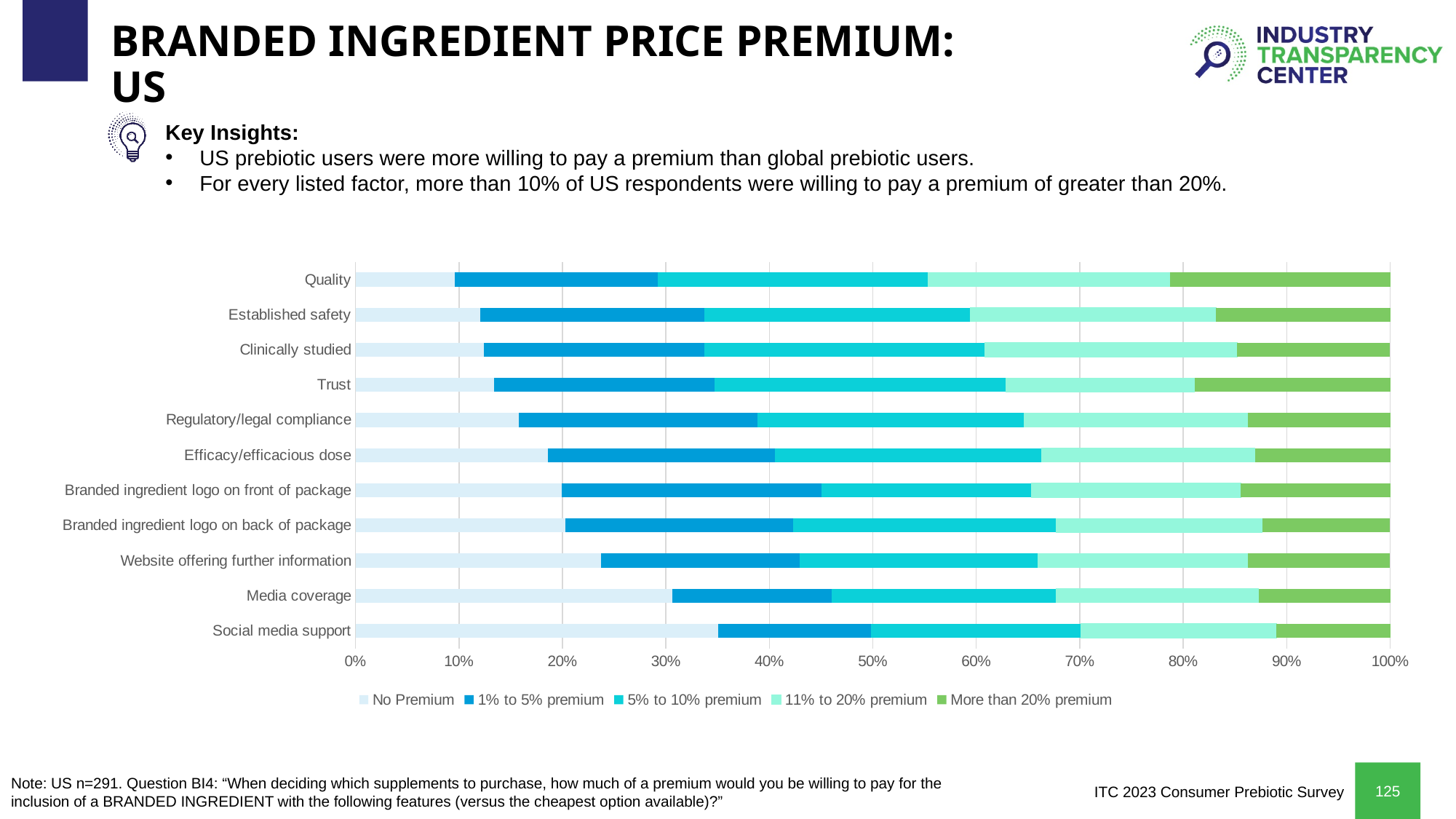
Which has a larger 'No Premium' share: Social media support or Quality? Social media support Which category has the largest 'No Premium' segment? Social media support How many factors (categories) are listed on the chart? 11 How many series does the chart legend list? 5 Which category has the smallest 'No Premium' segment? Quality What is the last series listed in the chart legend? More than 20% premium What kind of chart is shown on the slide? Stacked bar chart Moving down the list from Quality to Social media support, does the 'No Premium' segment grow or shrink? grows Is the 'No Premium' share for Social media support greater or less than 30%? greater Which category has the largest 'More than 20% premium' segment? Quality Is the 'No Premium' share for Website offering further information greater or less than 20%? greater